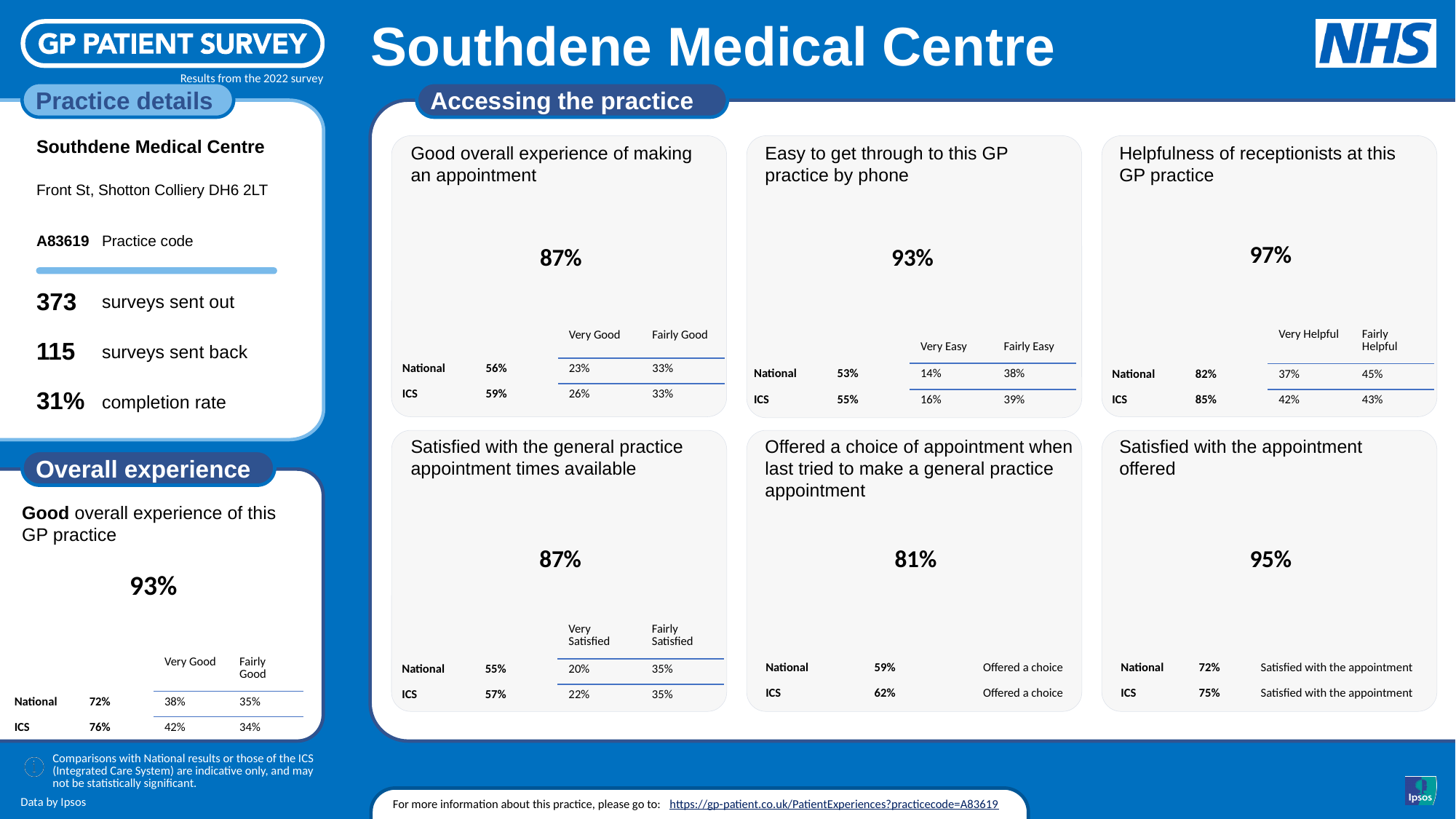
In the 'Helpfulness of receptionists at this GP practice' panel, what is the ICS 'Very Helpful' percentage? 42% In the 'Satisfied with the general practice appointment times available' panel, what is the National 'Fairly Satisfied' percentage? 35% In the 'Overall experience' panel, what is the practice's percentage for good overall experience of this GP practice? 93% How many result panels are shown under the 'Accessing the practice' heading? 6 In the 'Easy to get through to this GP practice by phone' panel, what is the National percentage? 53% In the 'Overall experience' panel, what is the difference between the ICS 'Very Good' and 'Fairly Good' percentages? 8% In the 'Easy to get through to this GP practice by phone' panel, which is larger, the ICS percentage or the National percentage? ICS In the 'Offered a choice of appointment when last tried to make a general practice appointment' panel, what is the ICS percentage? 62% Among the six 'Accessing the practice' panels, which has the lowest practice percentage? Offered a choice of appointment when last tried to make a general practice appointment In the 'Satisfied with the appointment offered' panel, what is the difference between the practice percentage and the National percentage? 23% In the 'Good overall experience of making an appointment' panel, what is the practice's percentage? 87% Among the six 'Accessing the practice' panels, which has the highest practice percentage? Helpfulness of receptionists at this GP practice